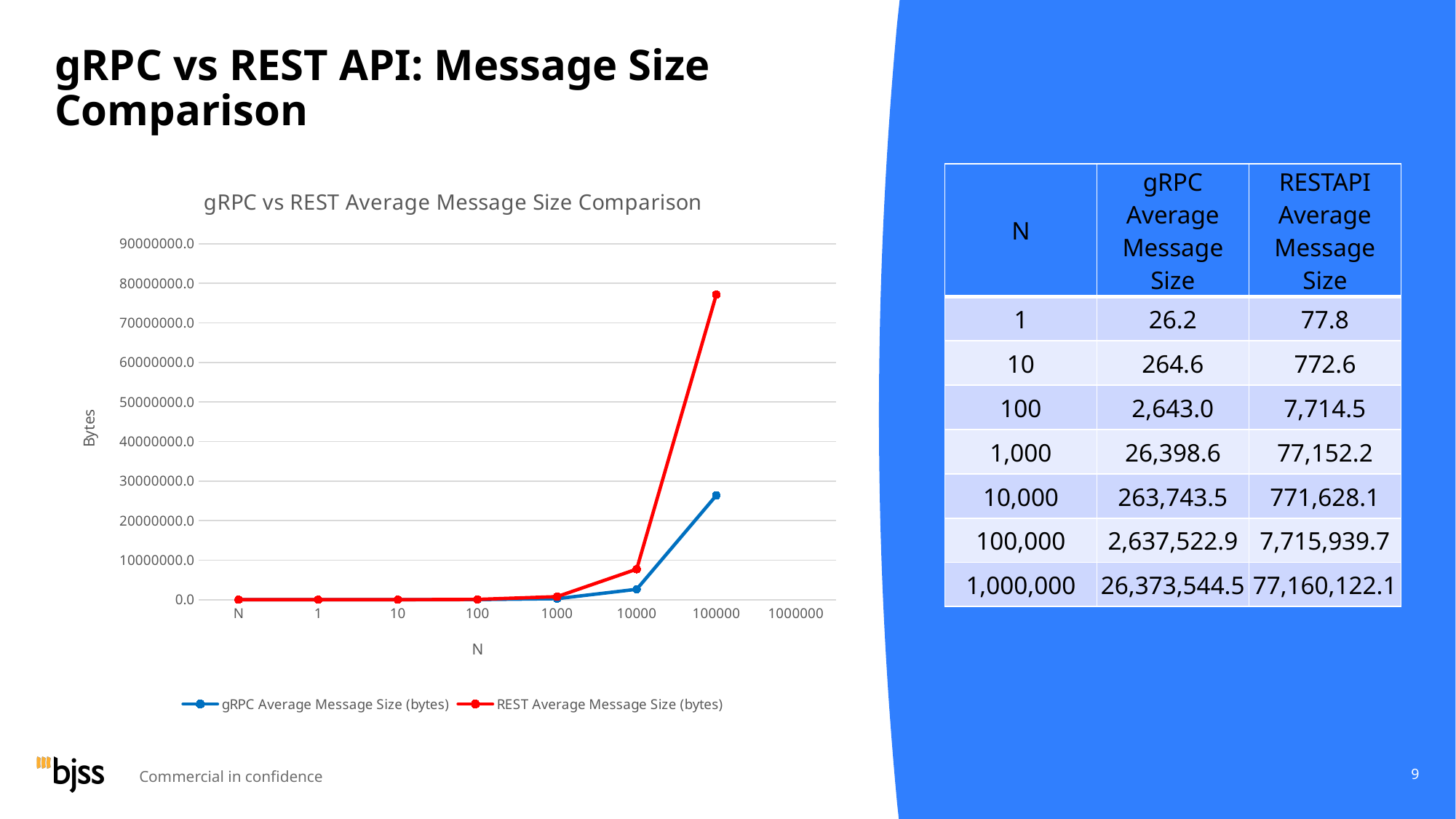
What is the title of the chart? gRPC vs REST Average Message Size Comparison Is the gRPC Average Message Size value at the x-axis label 100000 greater or less than 30000000.0? less At the x-axis label 100000, which series has the larger value, gRPC or REST? REST Average Message Size (bytes) How many tick labels are shown on the chart's x axis? 8 Is the REST Average Message Size value at the x-axis label 10000 greater or less than 10000000.0? less Is the REST Average Message Size value at the x-axis label 100000 greater or less than 70000000.0? greater Do the values of the REST series rise or fall as you move right along the x axis? rise What kind of chart is shown on the slide? Line chart How many series does the chart legend list? 2 Which series reaches the highest value on the chart? REST Average Message Size (bytes) What is the label on the chart's y axis? Bytes